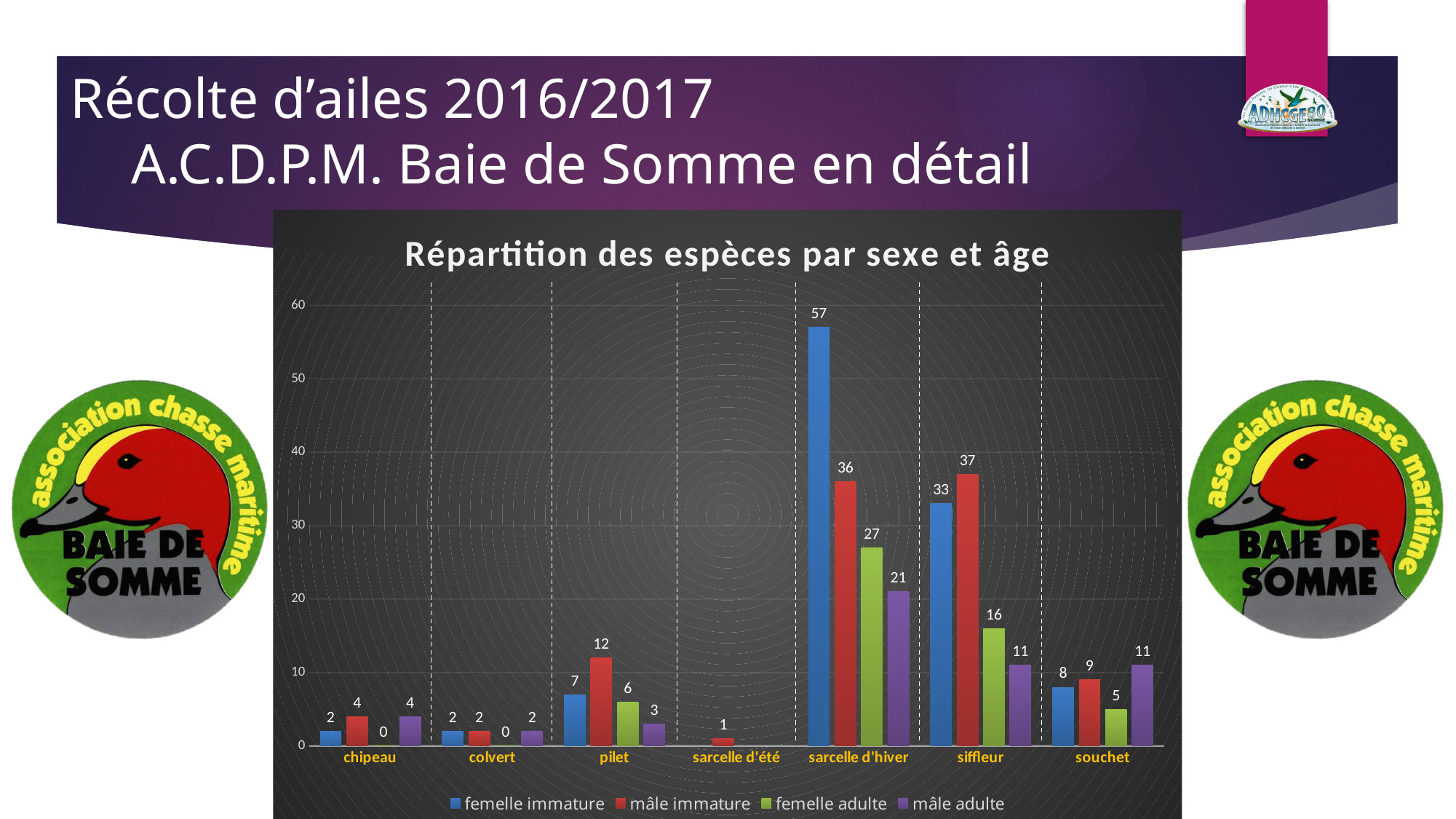
What is the value for femelle adulte for pilet? 6 What is the value for mâle adulte for souchet? 11 What is the value for mâle immature for siffleur? 37 Which category has the lowest mâle immature value? sarcelle d'été What is the title of the chart? Répartition des espèces par sexe et âge What kind of chart is shown on the slide? bar chart For siffleur, which is larger: femelle immature or mâle immature? mâle immature Which category has the highest femelle immature value? sarcelle d'hiver What is the difference between the femelle immature and mâle immature values for sarcelle d'hiver? 21 How many series does the legend list? 4 What is the value for femelle immature for sarcelle d'hiver? 57 How many categories are shown on the x axis? 7